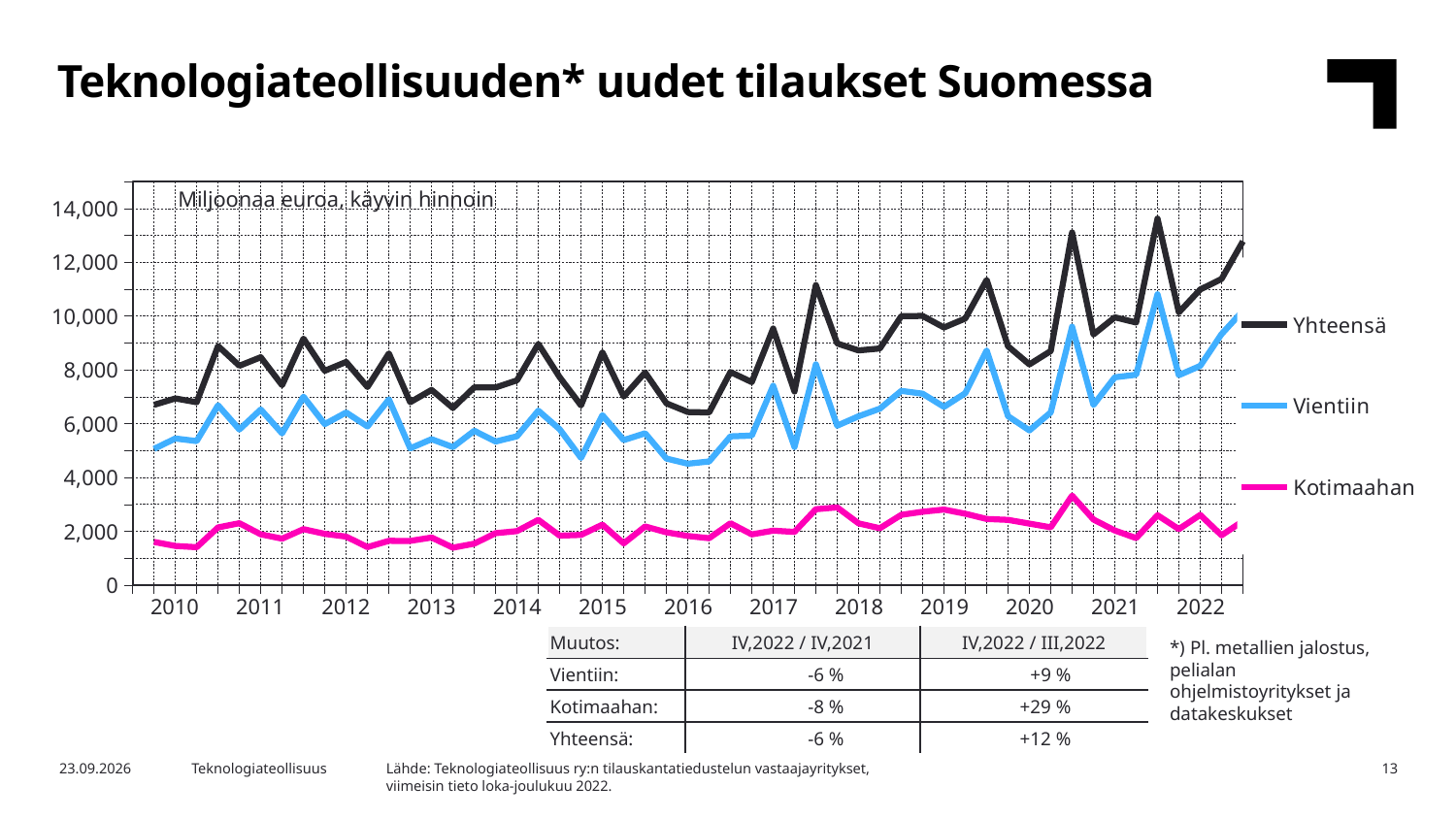
Which series has the lowest values throughout the chart? Kotimaahan How many series does the chart legend list? 3 Does the Vientiin series generally rise or fall between 2016 and 2022? rise How many years are labelled on the x axis? 13 What type of chart is shown on the slide? line chart Is the highest value reached by the Yhteensä series greater or less than 12,000? greater Which series has the highest values throughout the chart? Yhteensä Is the highest value reached by the Kotimaahan series greater or less than 4,000? less Is the value of the Yhteensä series at the start of 2010 greater or less than 6,000? greater What unit label is shown inside the chart's plot area? Miljoonaa euroa, käyvin hinnoin What are the three series named in the chart legend? Yhteensä, Vientiin, Kotimaahan